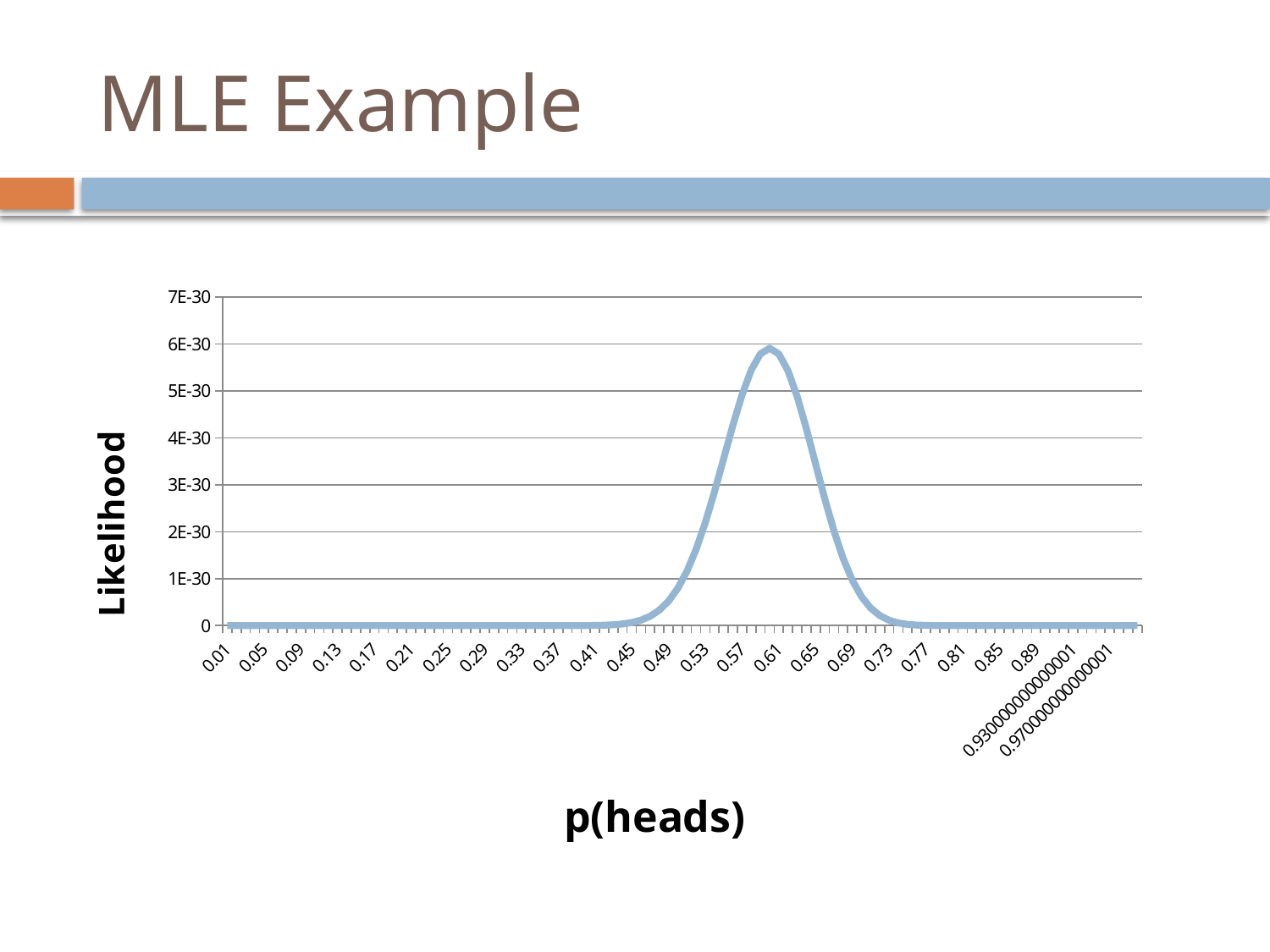
What is the title of the horizontal axis? p(heads) Is the likelihood at p(heads) = 0.53 greater or less than 1E-30? greater Is the likelihood at p(heads) = 0.61 greater or less than 5E-30? greater What kind of chart is shown on the slide? line chart Is the likelihood at p(heads) = 0.65 greater or less than 3E-30? greater At which value of p(heads) does the likelihood reach its highest point? 0.61 What is the title of the vertical axis? Likelihood Does the likelihood rise or fall as p(heads) goes from 0.45 to 0.61? rise Does the likelihood rise or fall as p(heads) goes from 0.61 to 0.77? fall Which has the larger likelihood, p(heads) = 0.53 or p(heads) = 0.61? 0.61